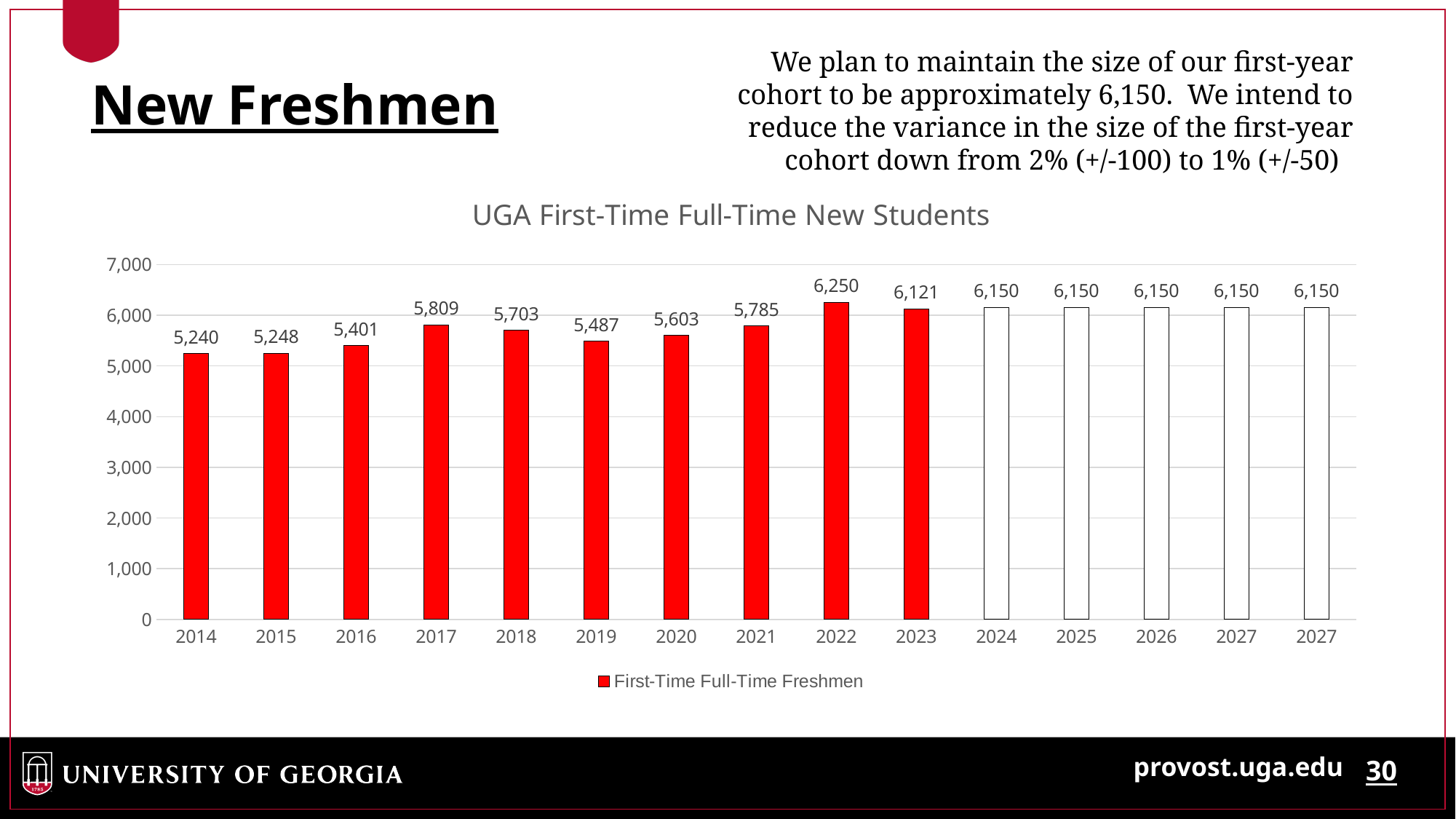
Which is larger, the value for 2017 or the value for 2018? 2017 What is the value for 2014 in the chart? 5,240 What is the value for 2019 in the chart? 5,487 What kind of chart is shown on the slide? bar chart Is the value for 2021 greater or less than 6,000? less What is the value for 2022 in the UGA First-Time Full-Time New Students chart? 6,250 What is the difference between the values for 2017 and 2016? 408 Which year has the highest value in the chart? 2022 How many series does the legend list? 1 What is the difference between the values for 2022 and 2023? 129 How many bars are plotted in the chart? 15 What is the value shown for 2024 in the chart? 6,150